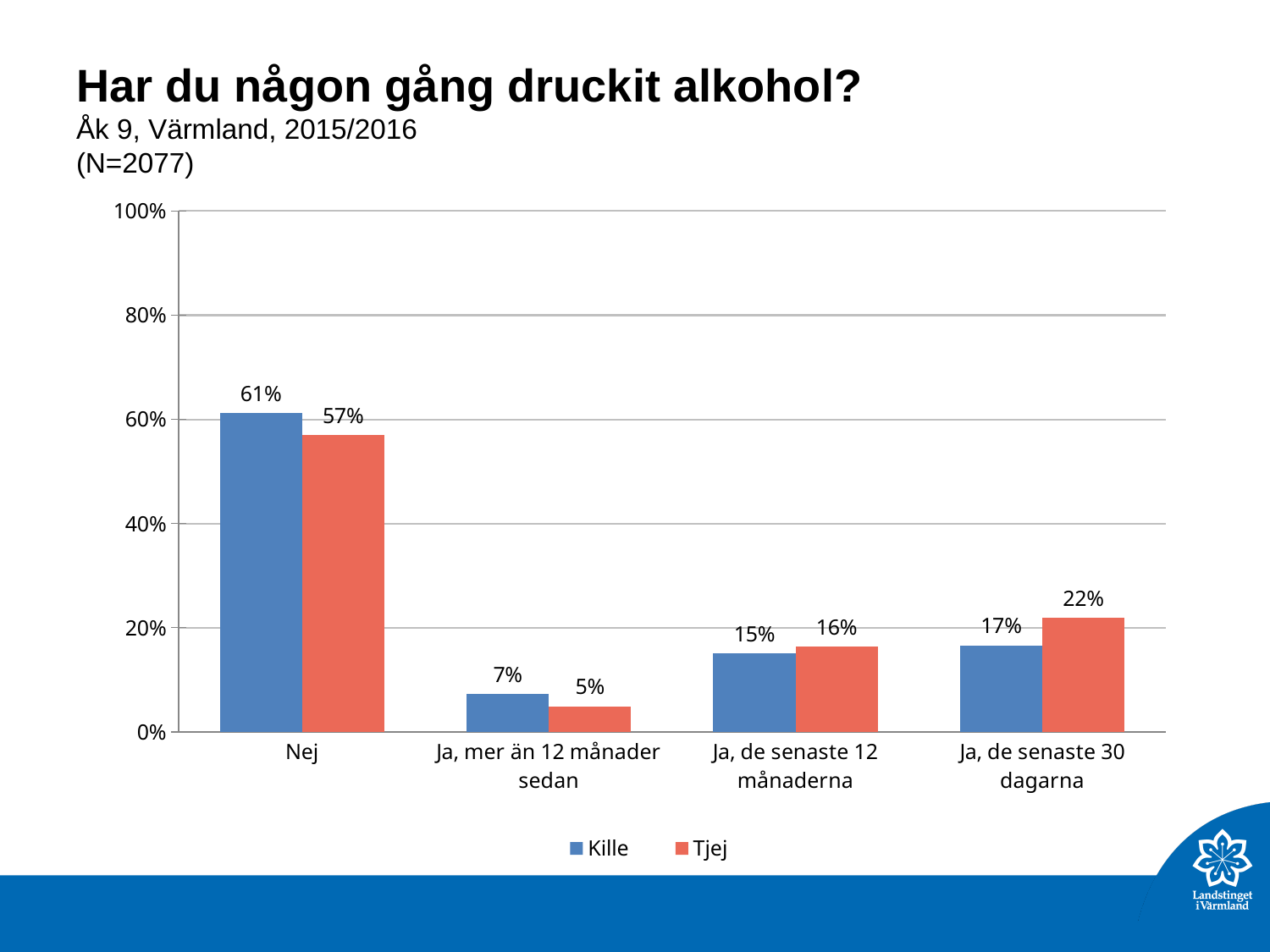
What is the value for Kille in the Nej category? 61% In the 'Ja, de senaste 30 dagarna' category, which series has the larger value, Kille or Tjej? Tjej What is the value for Tjej in the 'Ja, mer än 12 månader sedan' category? 5% How many categories are shown on the x axis? 4 What is the difference between Kille and Tjej in the Nej category? 4 percentage points What is the value for Tjej in the 'Ja, de senaste 30 dagarna' category? 22% Is the value for Tjej in the Nej category greater or less than 40%? greater What kind of chart is shown on the slide? Bar chart How many series does the legend list? 2 Which category has the highest value for Kille? Nej Which category has the lowest value for Tjej? Ja, mer än 12 månader sedan What is the title of the chart? Har du någon gång druckit alkohol?